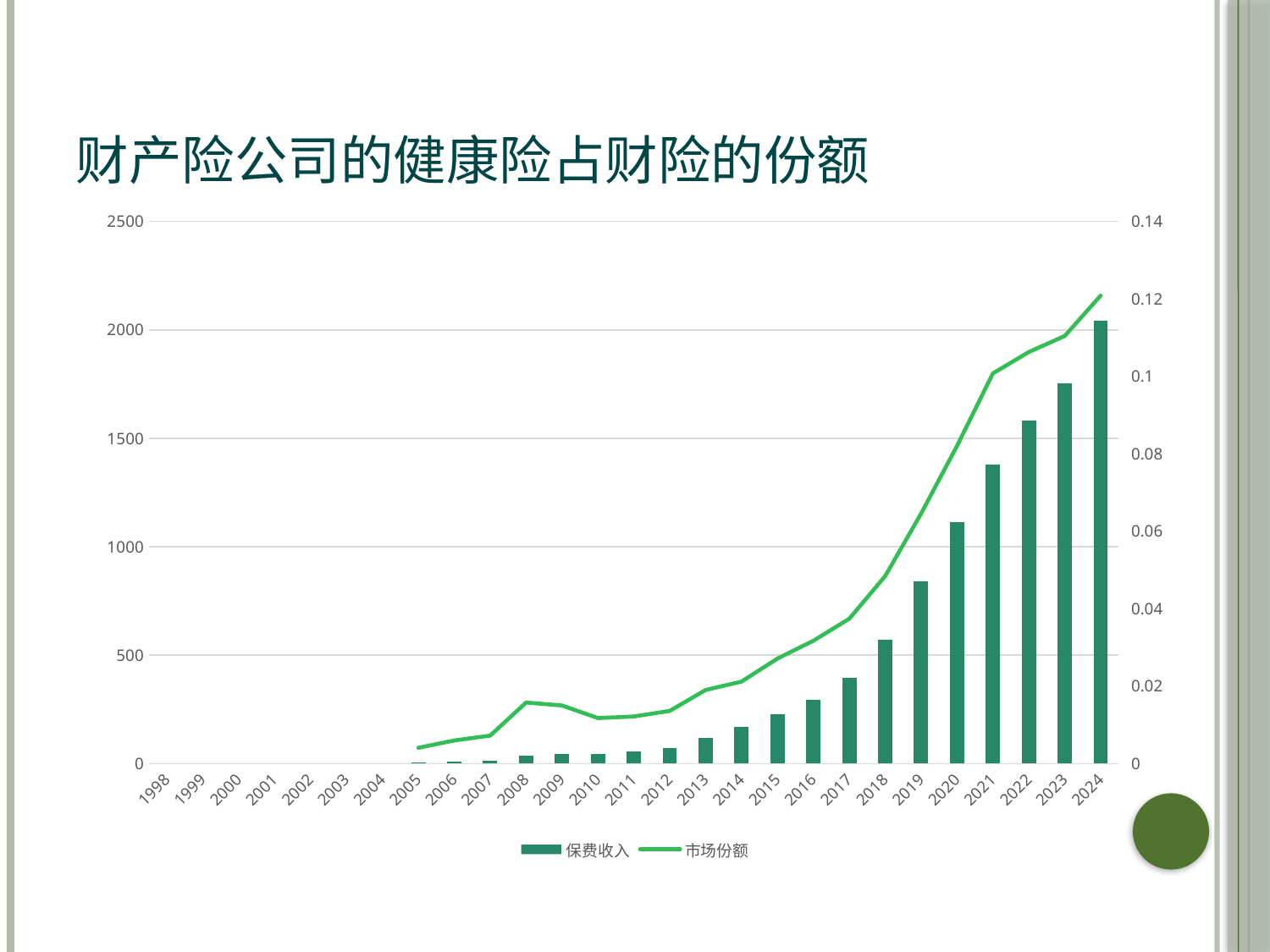
What kind of chart is this? A combined bar and line chart What is the title of the chart? 财产险公司的健康险占财险的份额 Which year has the larger 保费收入 bar, 2021 or 2023? 2023 How many series does the legend list? 2 Is the 市场份额 value for 2017 greater or less than 0.04? less Do the 保费收入 bars generally rise or fall from 2005 to 2024? rise In which year does the 市场份额 line reach its highest point? 2024 Which series is drawn as a line rather than bars? 市场份额 How many years are shown on the x axis? 27 Is the 保费收入 value for 2019 greater or less than 1000? less Is the 保费收入 value for 2023 greater or less than 1500? greater Which year has the highest 保费收入 bar? 2024